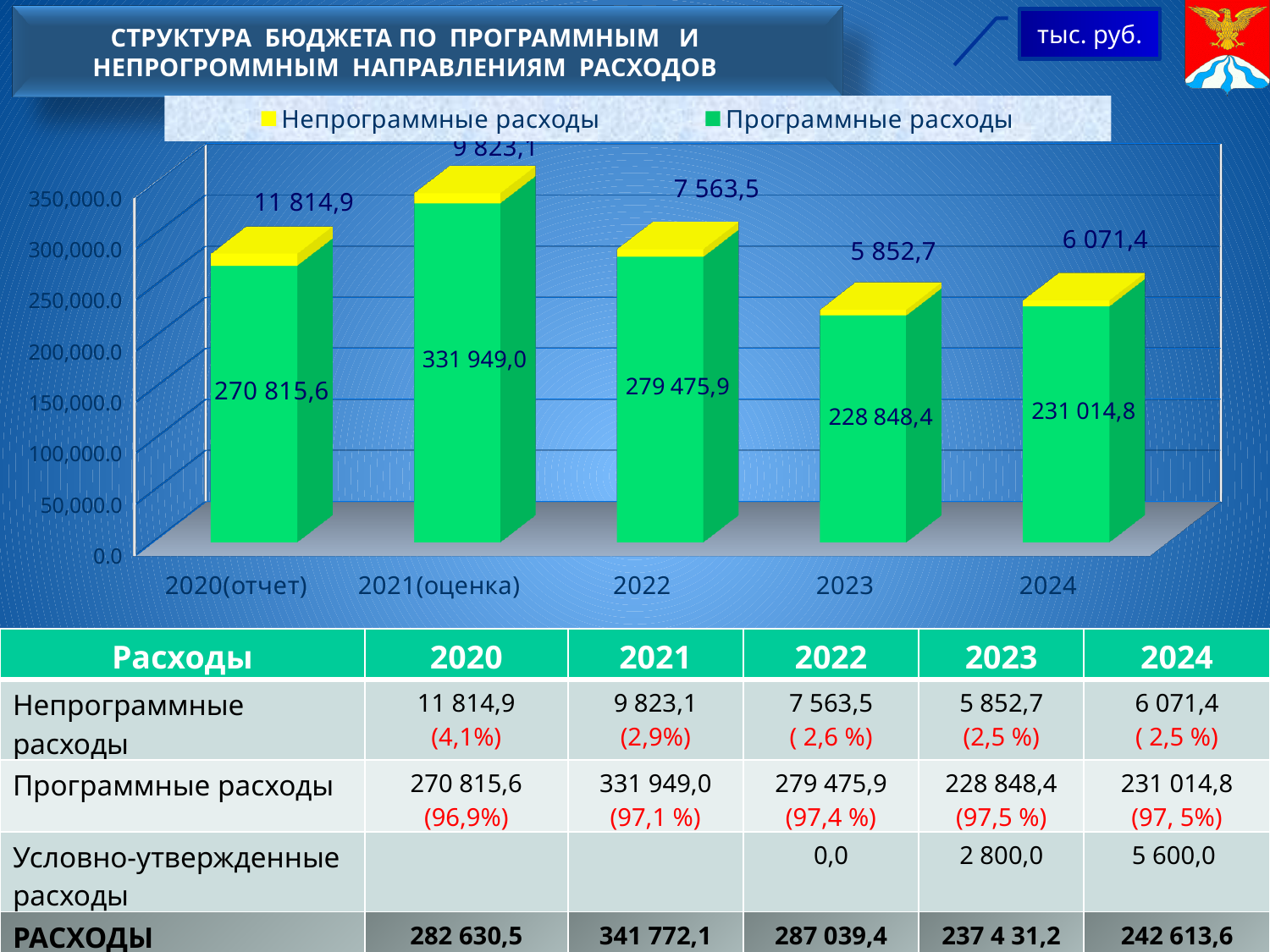
What is the value of Программные расходы for 2021(оценка)? 331 949,0 What is the value of Программные расходы for 2024? 231 014,8 What is the value of Непрограммные расходы for 2022? 7 563,5 Which colour represents Непрограммные расходы in the chart? yellow What is the total of the stacked bar for 2020(отчет)? 282 630,5 What is the difference between Программные расходы in 2021(оценка) and 2020(отчет)? 61 133,4 In which year are Непрограммные расходы the lowest? 2023 How many series does the chart legend list? 2 Which is larger: Непрограммные расходы in 2020(отчет) or in 2021(оценка)? 2020(отчет) In which year are Программные расходы the highest? 2021(оценка) How many categories (years) are shown on the x axis of the chart? 5 What type of chart is shown on the slide? stacked bar chart